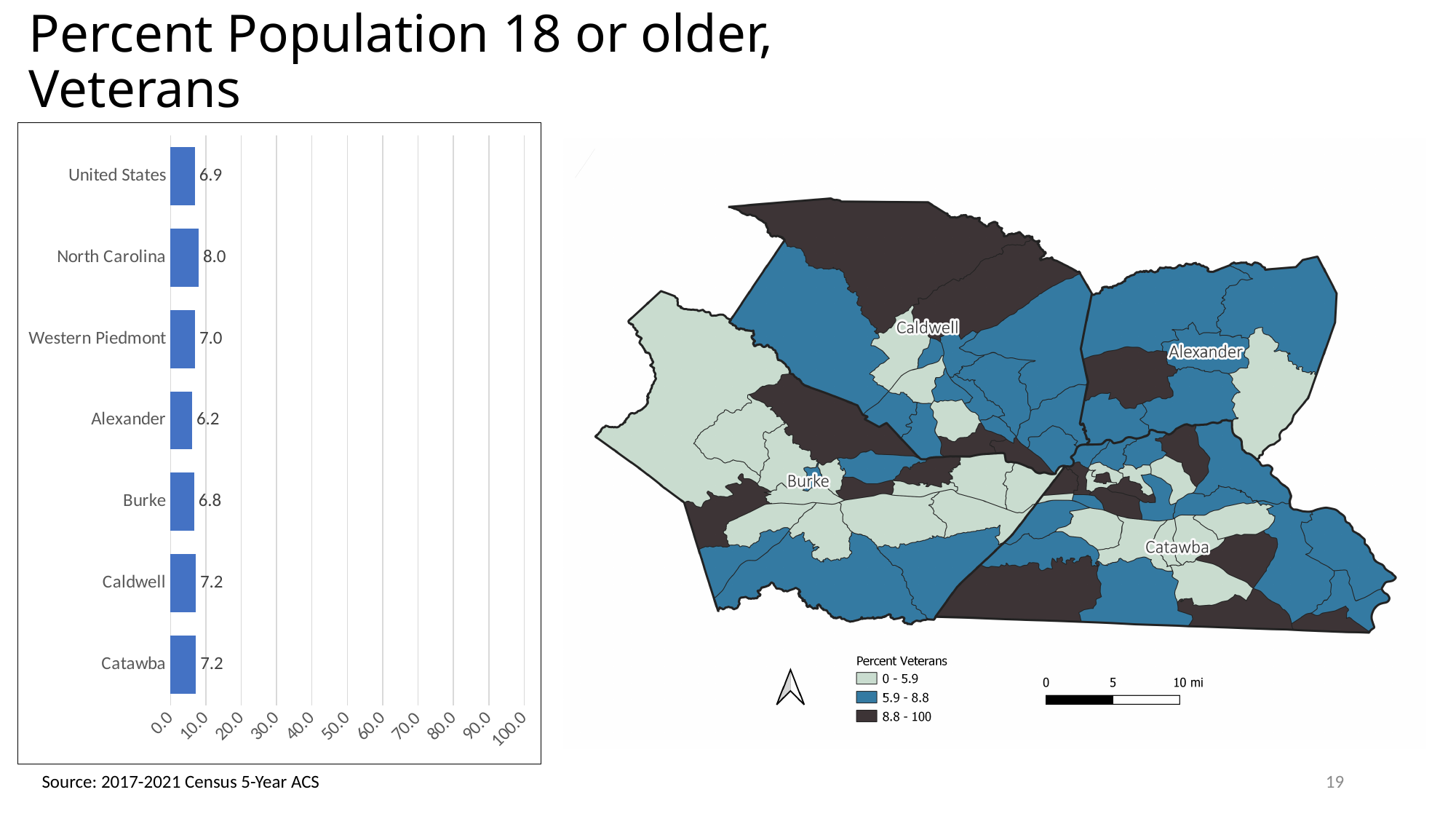
What is the highest value shown on the x axis of the bar chart? 100.0 What kind of chart is shown on the left of the slide? bar chart Which has a larger value in the bar chart, Western Piedmont or Burke? Western Piedmont Which category has the lowest value in the bar chart? Alexander What is the value for Alexander in the bar chart? 6.2 What is the difference between the values for North Carolina and Alexander in the bar chart? 1.8 What is the value for North Carolina in the bar chart? 8.0 Is the value for Caldwell in the bar chart greater or less than 10.0? less What is the value for the United States in the bar chart? 6.9 What is the value for Burke in the bar chart? 6.8 Which category has the highest value in the bar chart? North Carolina How many categories are shown in the bar chart? 7